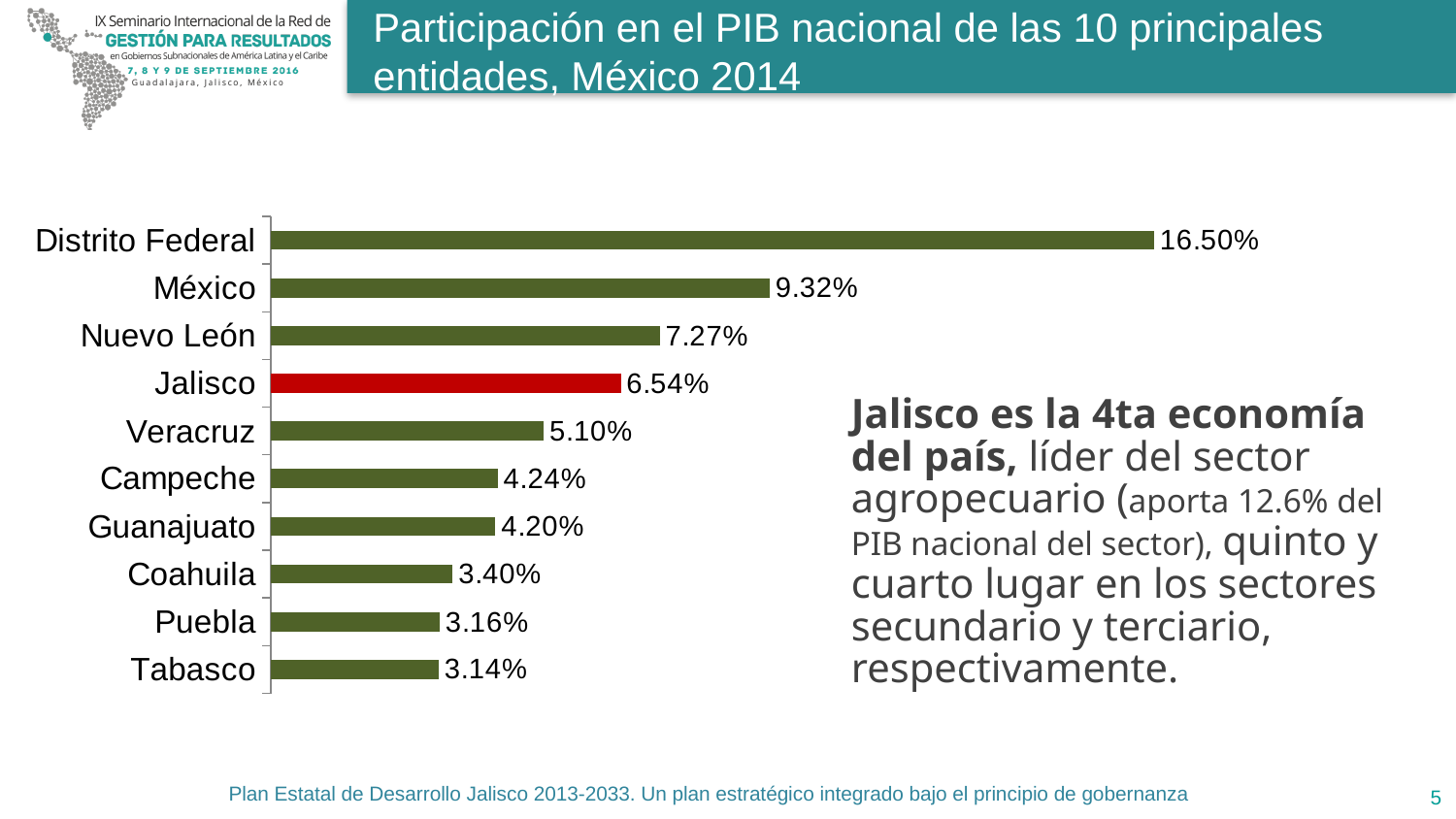
Which entity has the highest share of national GDP? Distrito Federal What is the difference between the values for Jalisco and Veracruz? 1.44% Which entity has the lowest value on the chart? Tabasco What is the value for Nuevo León? 7.27% What is the title of the chart? Participación en el PIB nacional de las 10 principales entidades, México 2014 What is the value for Jalisco? 6.54% What is the difference between the values for Distrito Federal and México? 7.18% What kind of chart is shown on the slide? Bar chart Which bar is highlighted in red? Jalisco How many entities are shown on the chart? 10 Which is larger, the value for Campeche or the value for Coahuila? Campeche What is the value for Tabasco? 3.14%